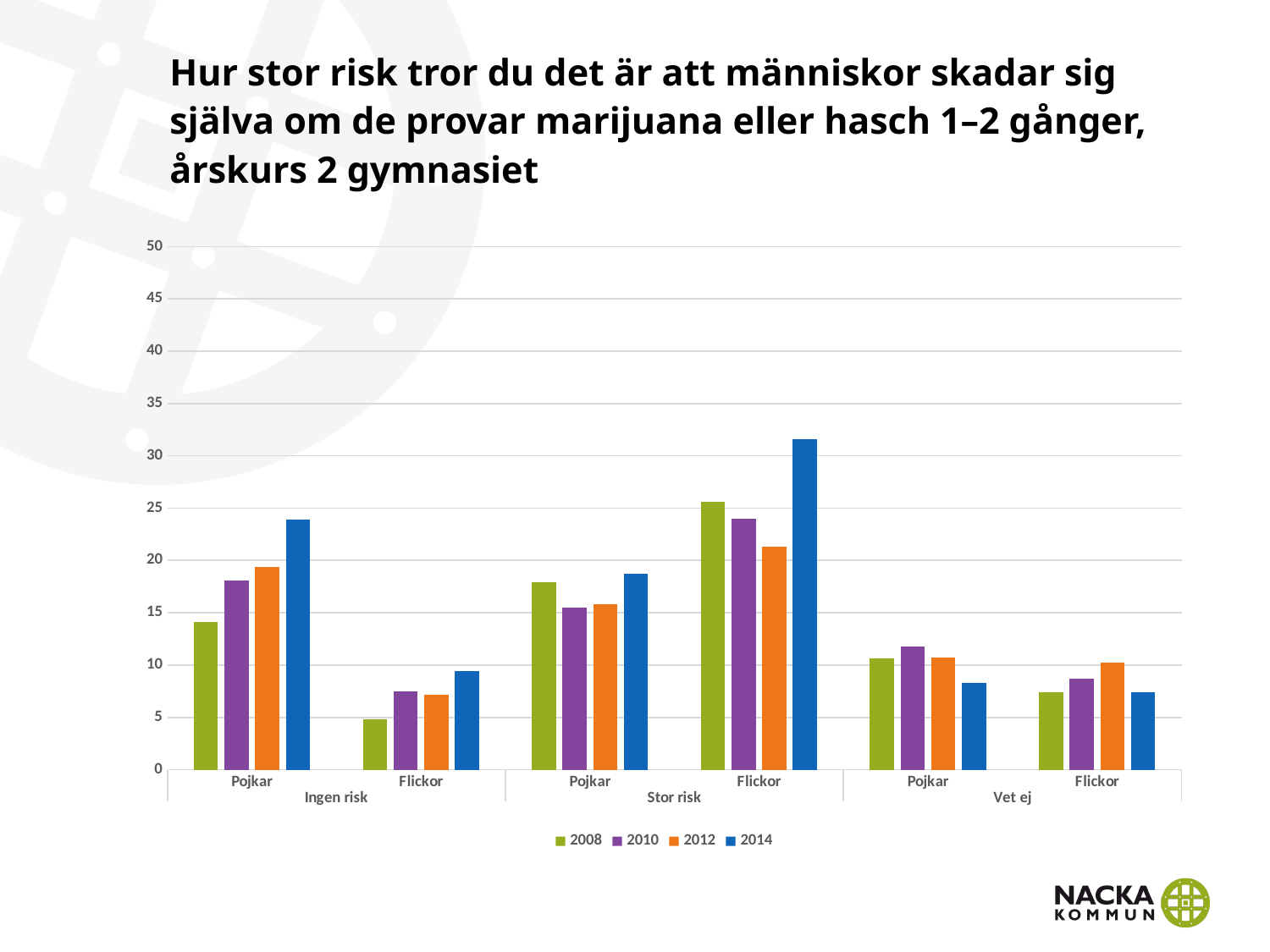
How many main response categories (Ingen risk, Stor risk, Vet ej) are shown on the x axis? 3 Is the 2014 value for Flickor under Stor risk greater or less than 30? greater For Pojkar under Ingen risk, do the values rise or fall from 2008 to 2014? rise Which group and year has the lowest bar in the chart? Flickor, Ingen risk, 2008 What kind of chart is shown on the slide? Bar chart How many series does the legend list? 4 Is the 2014 value for Pojkar under Ingen risk greater or less than 20? greater For Pojkar under Ingen risk, which year has the larger value, 2008 or 2014? 2014 What colour represents the 2014 series in the legend? Blue Which group and year has the highest bar in the chart? Flickor, Stor risk, 2014 For Pojkar under Vet ej, which year has the larger value, 2010 or 2014? 2010